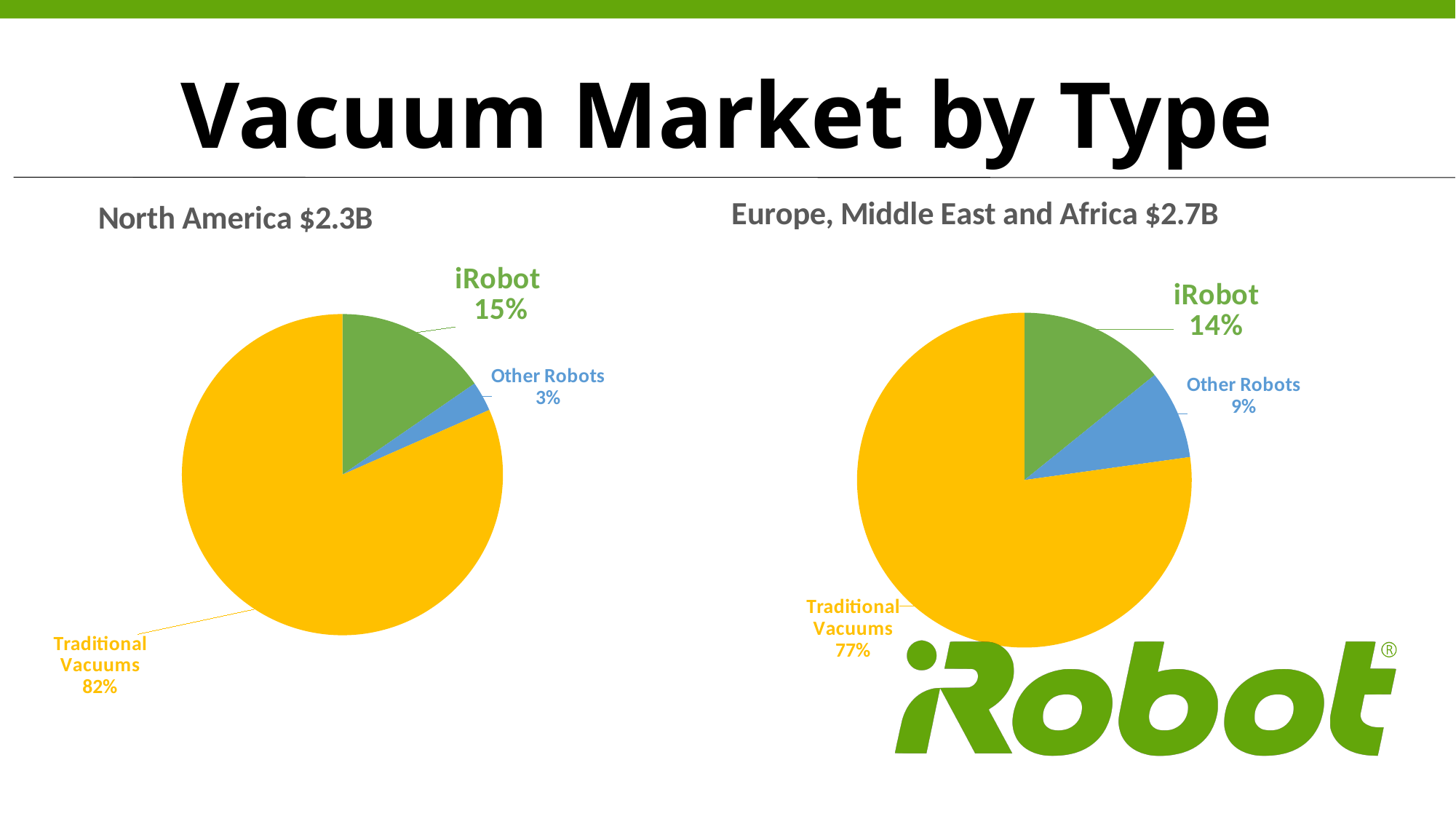
In the North America $2.3B pie chart, what share does iRobot hold? 15% In the Europe, Middle East and Africa $2.7B pie chart, what is the difference between the iRobot share and the Other Robots share? 5% In the Europe, Middle East and Africa $2.7B pie chart, what share do Traditional Vacuums hold? 77% What colour is the iRobot slice in the North America $2.3B pie chart? Green How many slices does the North America $2.3B pie chart have? 3 In the Europe, Middle East and Africa $2.7B pie chart, what share do Other Robots hold? 9% In the North America $2.3B pie chart, what share do Traditional Vacuums hold? 82% In the North America $2.3B pie chart, what is the difference between the iRobot share and the Other Robots share? 12% What type of chart is used for the Europe, Middle East and Africa $2.7B data? Pie chart Which pie chart shows a larger share for Other Robots, North America or Europe, Middle East and Africa? Europe, Middle East and Africa In the Europe, Middle East and Africa $2.7B pie chart, which category has the largest share? Traditional Vacuums In the North America $2.3B pie chart, which category has the smallest share? Other Robots